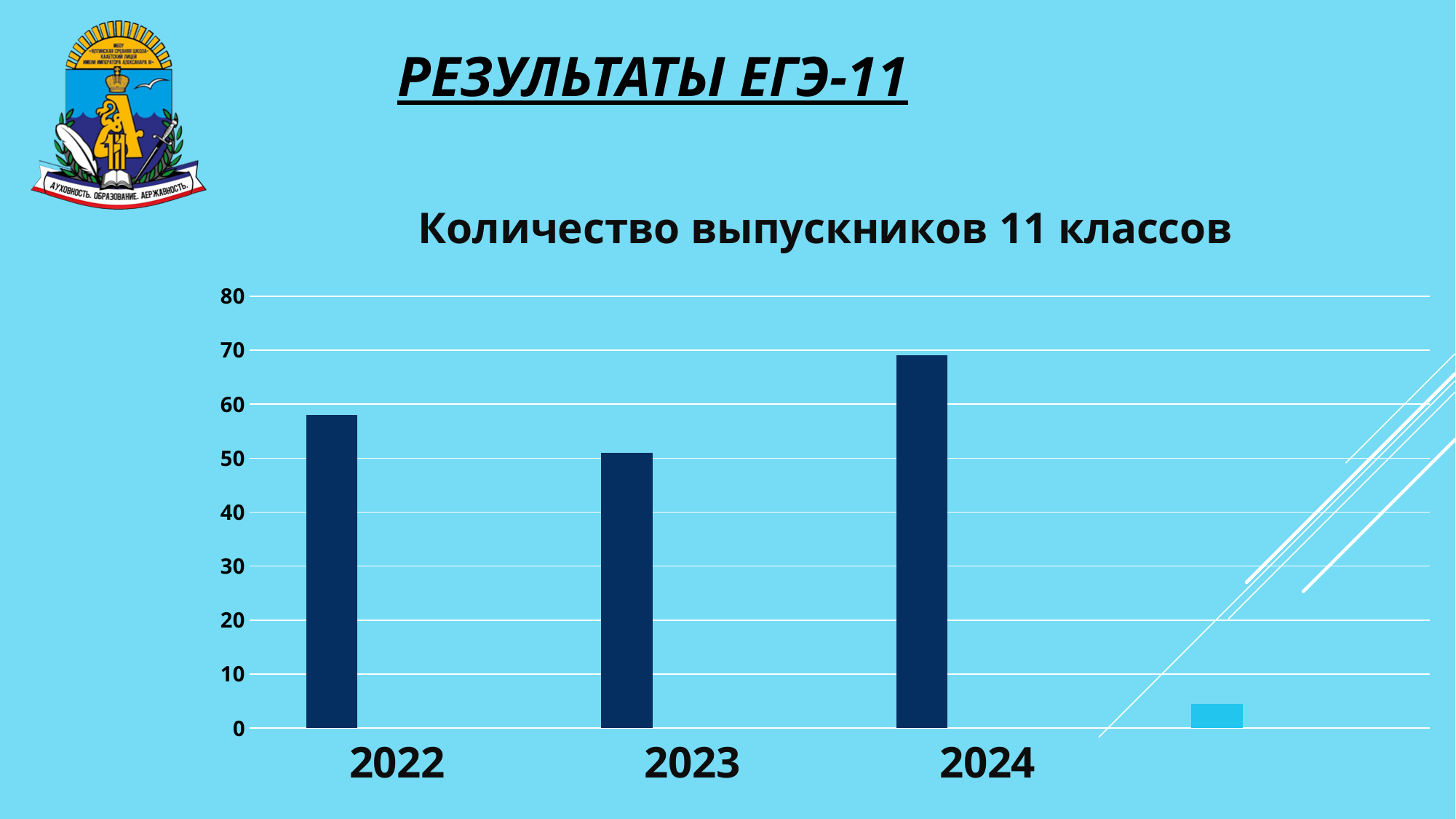
Is the value for 2023 greater or less than 60? less What kind of chart is shown on the slide? bar chart Which is larger, the value for 2022 or the value for 2023? 2022 What is the highest value shown on the y axis of the chart? 80 Does the value rise or fall from 2023 to 2024? rise How many years are labeled on the x axis of the chart? 3 Among 2022, 2023 and 2024, which year has the lowest bar? 2023 Which is larger, the value for 2024 or the value for 2022? 2024 Is the value for 2024 greater or less than 60? greater What is the title of the chart on the slide? Количество выпускников 11 классов Is the value for 2022 greater or less than 50? greater Which year has the highest bar in the chart? 2024